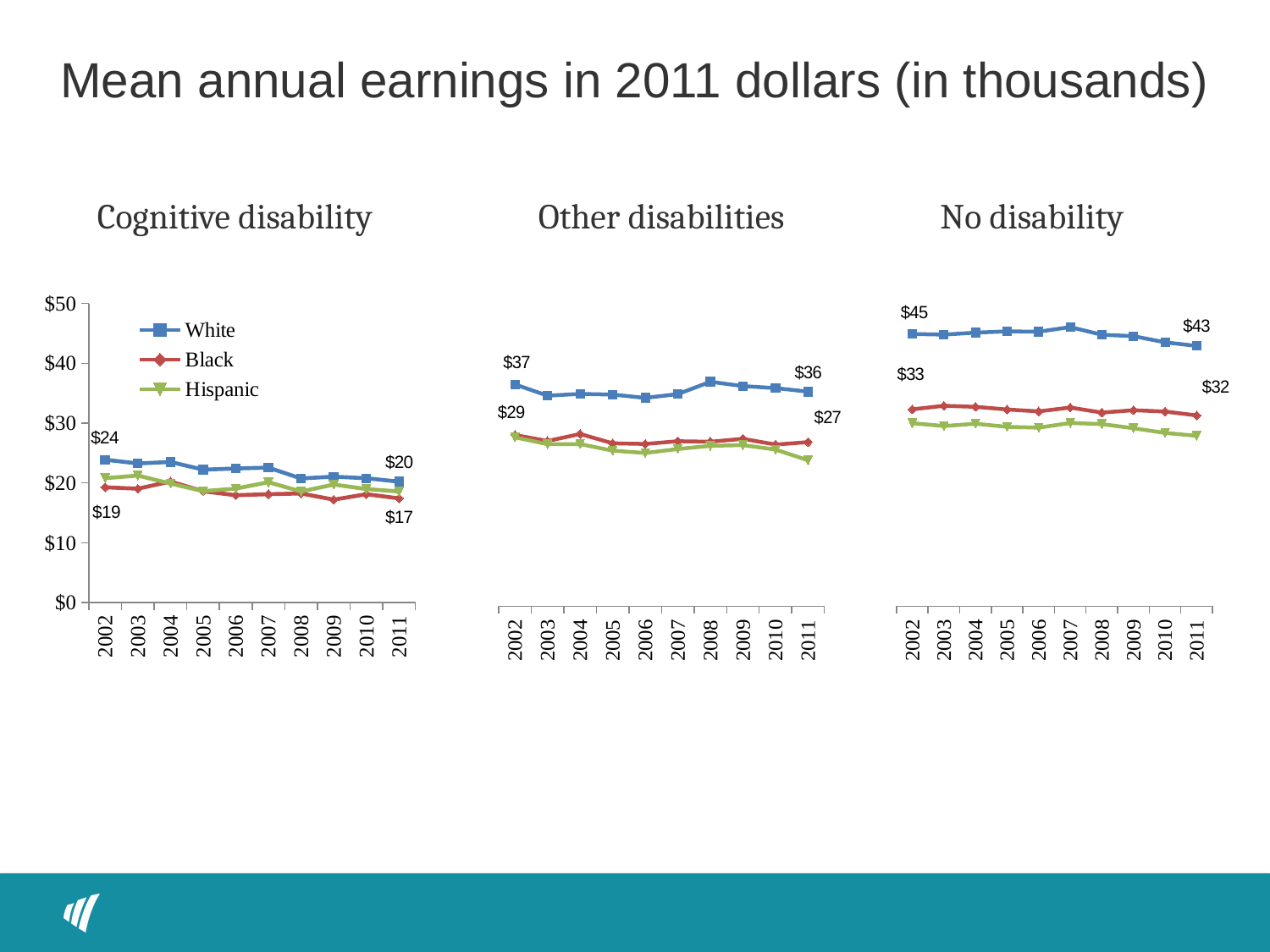
In the Other disabilities chart, what is the value for White in 2011? $36 In the No disability chart, which series has the highest values across all years? White In the No disability chart, what is the value for Black in 2011? $32 How many series does the legend in the Cognitive disability chart list? 3 In the No disability chart, what is the value for White in 2002? $45 In the Cognitive disability chart, by how much did the White value fall from 2002 to 2011? $4 How many years are shown on the x axis of each chart? 10 In the Cognitive disability chart, what is the value for White in 2002? $24 In the Other disabilities chart, is the Hispanic value in 2011 greater or less than $30? less In the Cognitive disability chart, what is the value for Black in 2011? $17 In the Other disabilities chart, what is the difference between the White and Black values in 2002? $8 In the Cognitive disability chart, which is larger in 2011: the White value or the Black value? White